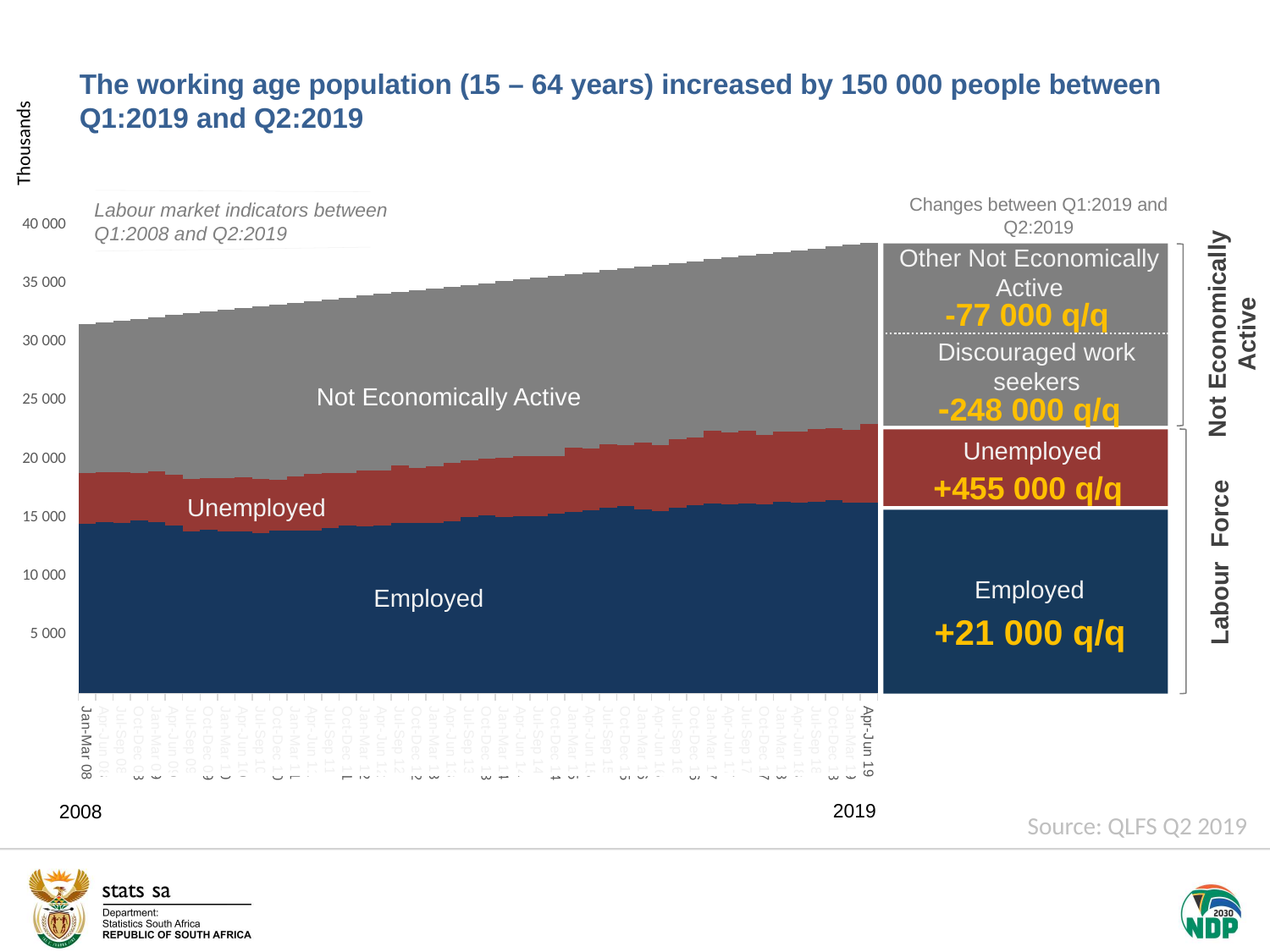
Which group had the largest decrease between Q1:2019 and Q2:2019? Discouraged work seekers In Apr-Jun 19, is the total working age population greater or less than 35 000 thousand? greater In what unit are the values on the vertical axis of the chart expressed? Thousands Which group had the largest increase between Q1:2019 and Q2:2019? Unemployed Does the total working age population rise or fall from 2008 to 2019 in the chart? Rise What was the quarter-on-quarter change for Discouraged work seekers between Q1:2019 and Q2:2019? -248 000 q/q How many series are shown in the stacked chart of labour market indicators? 3 What kind of chart is used to show the labour market indicators between Q1:2008 and Q2:2019? Stacked bar chart What was the quarter-on-quarter change in the number of Unemployed between Q1:2019 and Q2:2019? +455 000 q/q What was the quarter-on-quarter change in the number of Employed between Q1:2019 and Q2:2019? +21 000 q/q What was the quarter-on-quarter change for Other Not Economically Active between Q1:2019 and Q2:2019? -77 000 q/q In Apr-Jun 19, is the number of Employed greater or less than 15 000 thousand? greater